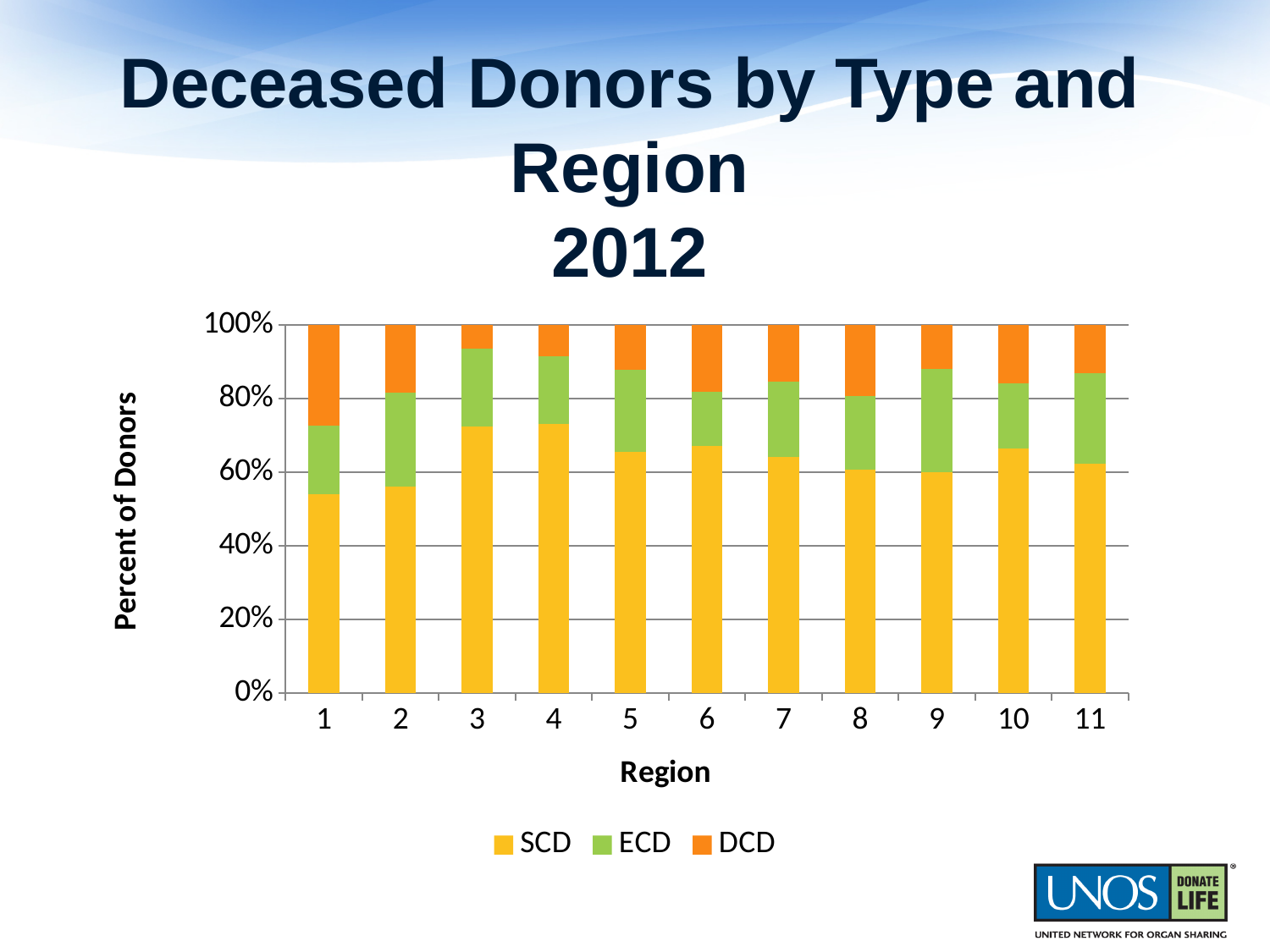
What are the three donor types listed in the legend? SCD, ECD, DCD Which region has the largest DCD share? Region 1 What is the label on the vertical axis of the chart? Percent of Donors How many series does the chart's legend list? 3 Is the SCD value for Region 3 greater or less than 60%? greater How many regions are shown on the x axis of the chart? 11 Which is larger, the SCD share for Region 3 or for Region 1? Region 3 Is the SCD value for Region 1 greater or less than 60%? less Is the SCD value for Region 4 greater or less than 60%? greater What does each stacked bar in the chart total? 100% Which is larger, the DCD share for Region 1 or for Region 3? Region 1 What kind of chart is shown on the slide? Stacked bar chart